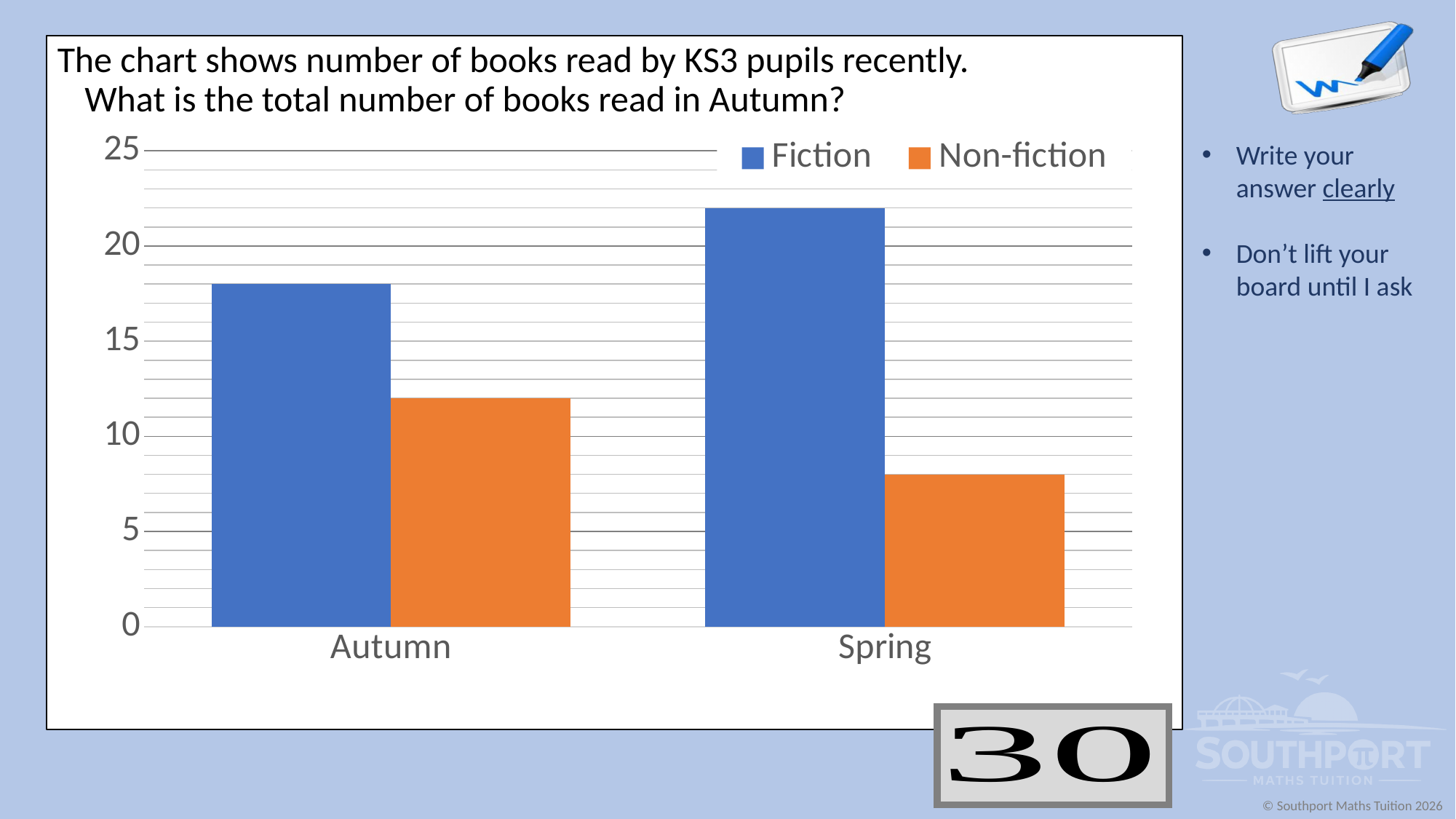
Is the Fiction value for Spring greater or less than 20? greater Which series is shown in orange? Non-fiction How many categories are shown on the x axis? 2 Is the Fiction value for Autumn greater or less than 15? greater Which category has the higher Fiction value, Autumn or Spring? Spring Which series is shown in blue? Fiction Which category has the lower Non-fiction value? Spring Which bar is the tallest in the chart? Fiction for Spring Is the Non-fiction value for Autumn greater or less than 10? greater What kind of chart is shown on the slide? bar chart How many series does the legend list? 2